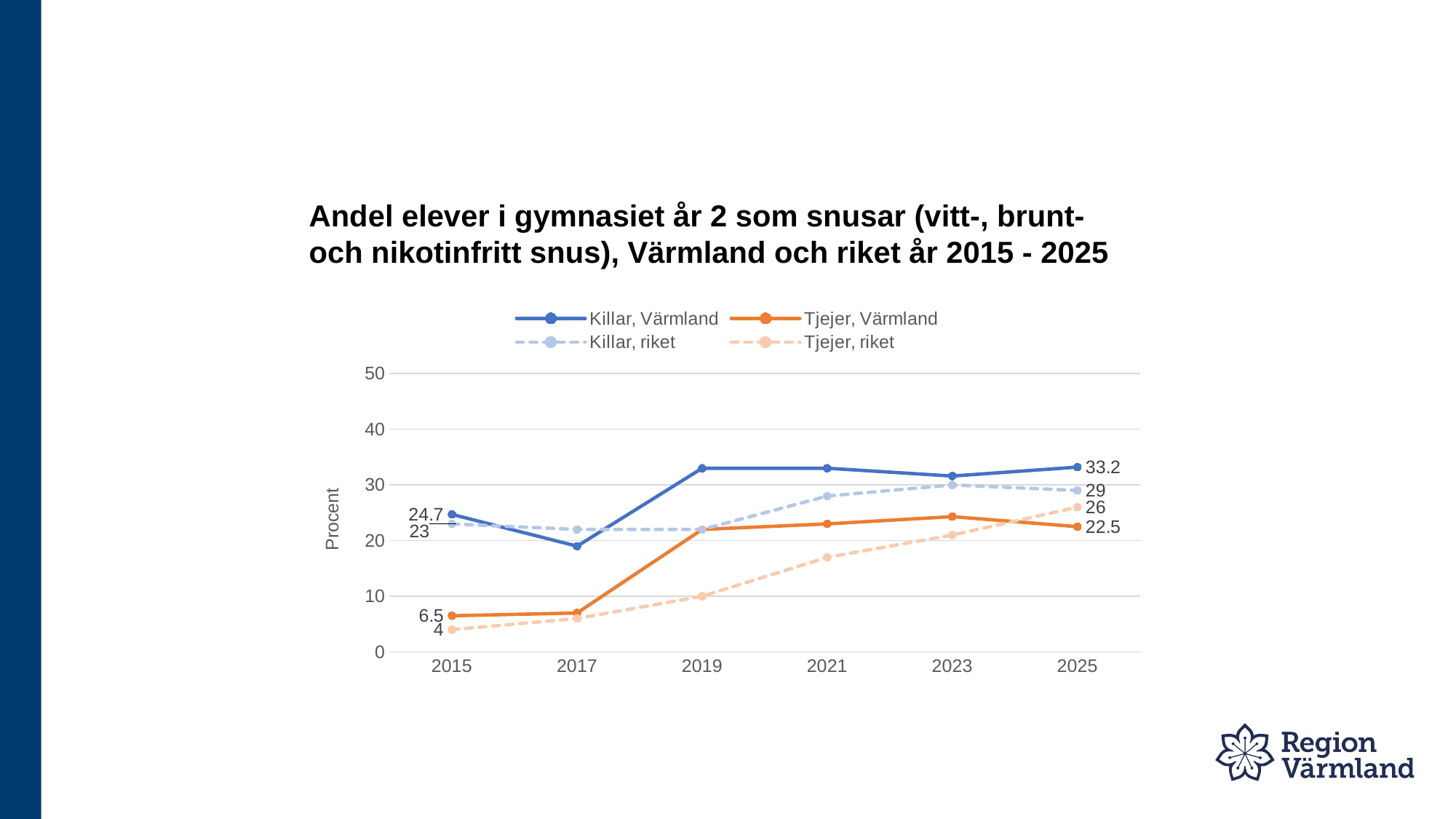
Which series has the highest value in 2025? Killar, Värmland In 2025, which is larger: Tjejer, riket or Tjejer, Värmland? Tjejer, riket Is the value for Tjejer, Värmland in 2021 greater or less than 30? less What is the difference between the Killar, Värmland values in 2025 and 2015? 8.5 Which series has the lowest value in 2015? Tjejer, riket How many series does the legend list? 4 What is the value for Killar, riket in 2015? 23 What is the value for Tjejer, Värmland in 2015? 6.5 How many years are shown on the x axis? 6 What kind of chart is shown on the slide? line chart What is the value for Killar, Värmland in 2025? 33.2 What is the value for Tjejer, riket in 2025? 26